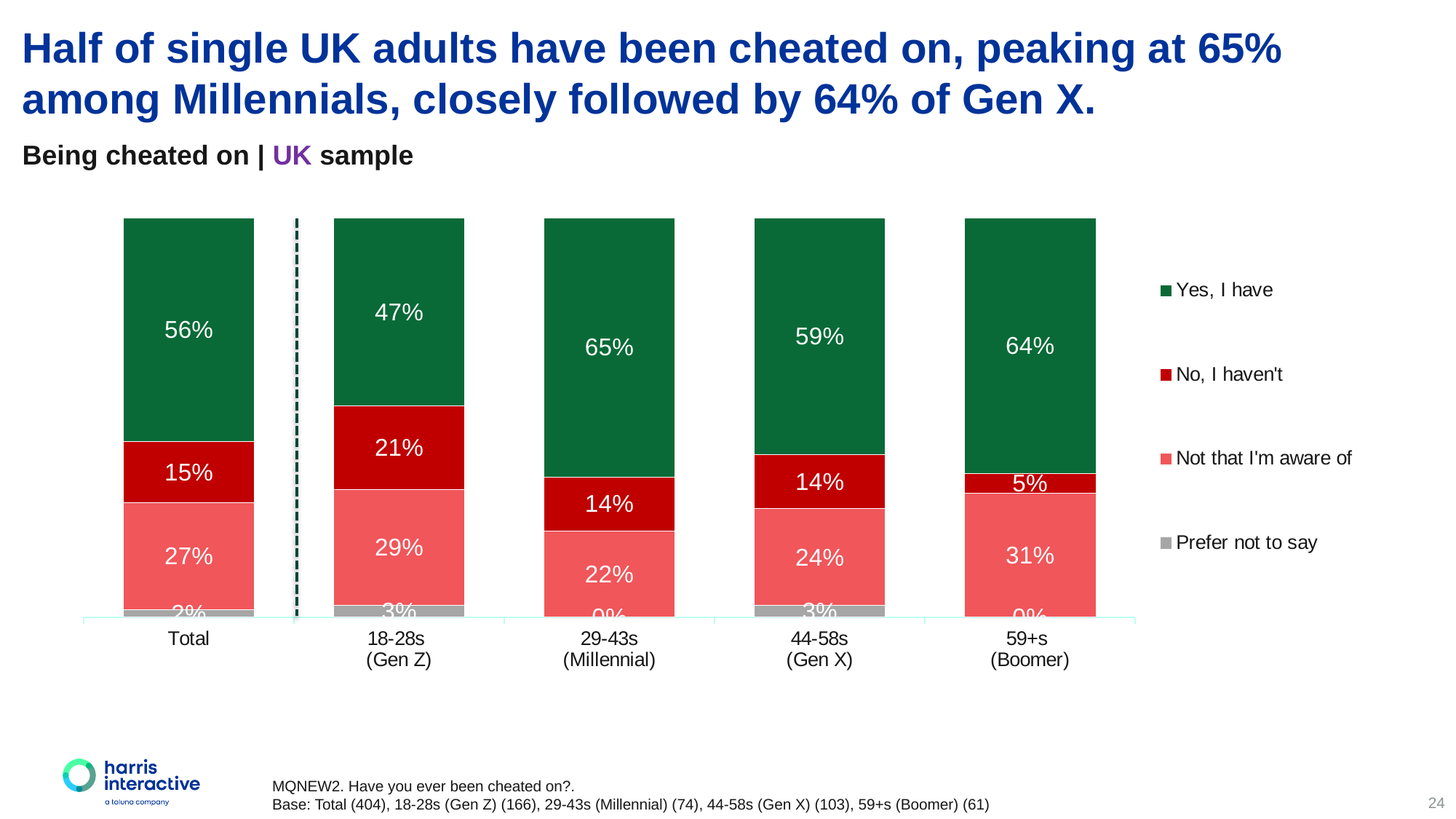
What percentage of the Total sample answered "Not that I'm aware of"? 27% What percentage of 18-28s (Gen Z) answered "Prefer not to say"? 3% What is the difference between the "Yes, I have" share for 29-43s (Millennial) and for 18-28s (Gen Z)? 18 percentage points Which is larger: the "No, I haven't" share for 18-28s (Gen Z) or for 44-58s (Gen X)? 18-28s (Gen Z) How many age groups (including Total) are shown on the x axis? 5 How many series does the legend list? 4 What percentage of 29-43s (Millennial) answered "Yes, I have"? 65% Which age group has the lowest share answering "Yes, I have"? 18-28s (Gen Z) Which age group has the highest share answering "Yes, I have"? 29-43s (Millennial) What percentage of 59+s (Boomer) answered "No, I haven't"? 5% What kind of chart is shown on the slide? Stacked bar chart Which legend entry is shown in green? Yes, I have